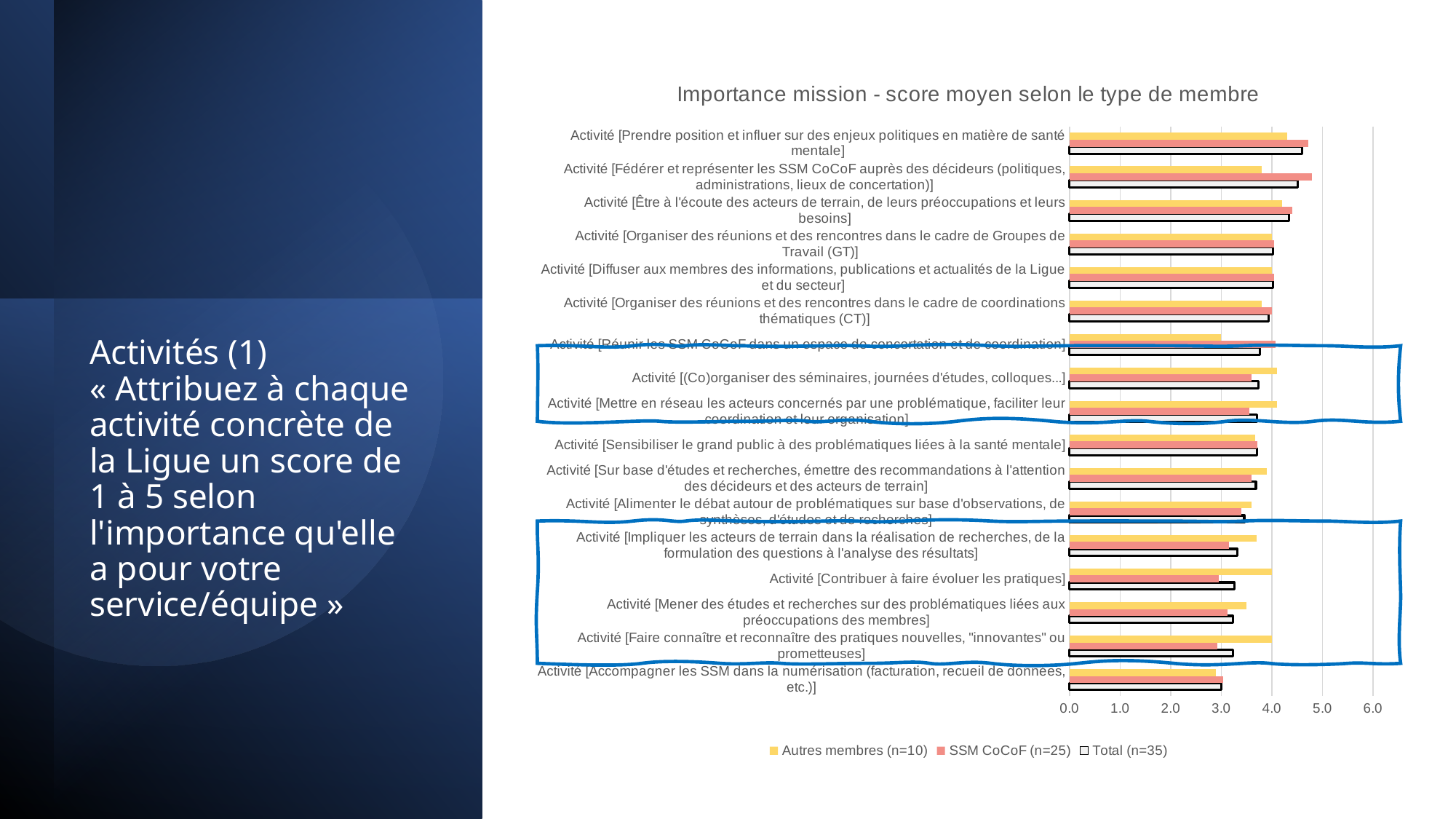
Which series are listed in the legend? Autres membres (n=10), SSM CoCoF (n=25), Total (n=35) What is the title of the chart? Importance mission - score moyen selon le type de membre Is the Total (n=35) value for 'Activité [Impliquer les acteurs de terrain dans la réalisation de recherches, de la formulation des questions à l'analyse des résultats]' greater or less than 4.0? less What kind of chart is shown on the slide? Bar chart Is the Total (n=35) value for 'Activité [Prendre position et influer sur des enjeux politiques en matière de santé mentale]' greater or less than 4.0? greater How many series does the legend list? 3 For 'Activité [Contribuer à faire évoluer les pratiques]', which series has the larger value: Autres membres (n=10) or SSM CoCoF (n=25)? Autres membres (n=10) For 'Activité [Faire connaître et reconnaître des pratiques nouvelles, "innovantes" ou prometteuses]', which series has the larger value: Autres membres (n=10) or SSM CoCoF (n=25)? Autres membres (n=10) For 'Activité [Fédérer et représenter les SSM CoCoF auprès des décideurs (politiques, administrations, lieux de concertation)]', which series has the larger value: Autres membres (n=10) or SSM CoCoF (n=25)? SSM CoCoF (n=25) How many activities (categories) are plotted in the chart? 17 Is the Autres membres (n=10) value for 'Activité [Prendre position et influer sur des enjeux politiques en matière de santé mentale]' greater or less than 4.0? greater